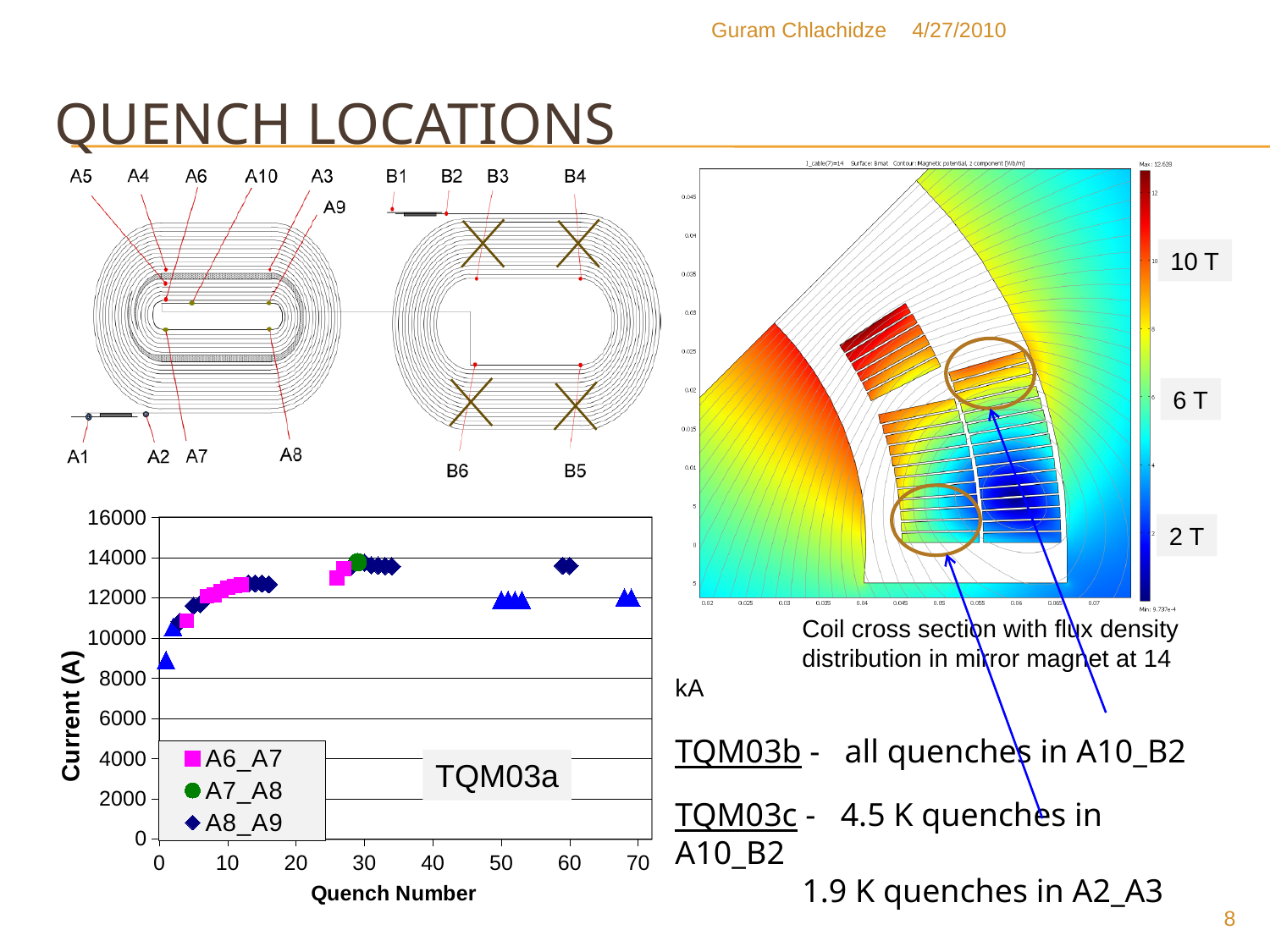
What are the three series named in the legend of the TQM03a chart? A6_A7, A7_A8, A8_A9 In the TQM03a chart, do the current values rise or fall as the quench number increases from 1 to 30? rise In the TQM03a chart, is the current for the first quench (quench number 1) greater or less than 10000? less In the TQM03a chart, is the current for the A6_A7 quenches near quench number 10 greater or less than 14000? less What kind of chart is the TQM03a chart at the bottom left of the slide? scatter chart In the TQM03a chart, is the current for the A8_A9 quenches near quench number 33 greater or less than 12000? greater How many series does the legend of the TQM03a chart list? 3 What is the label on the y axis of the TQM03a chart? Current (A)